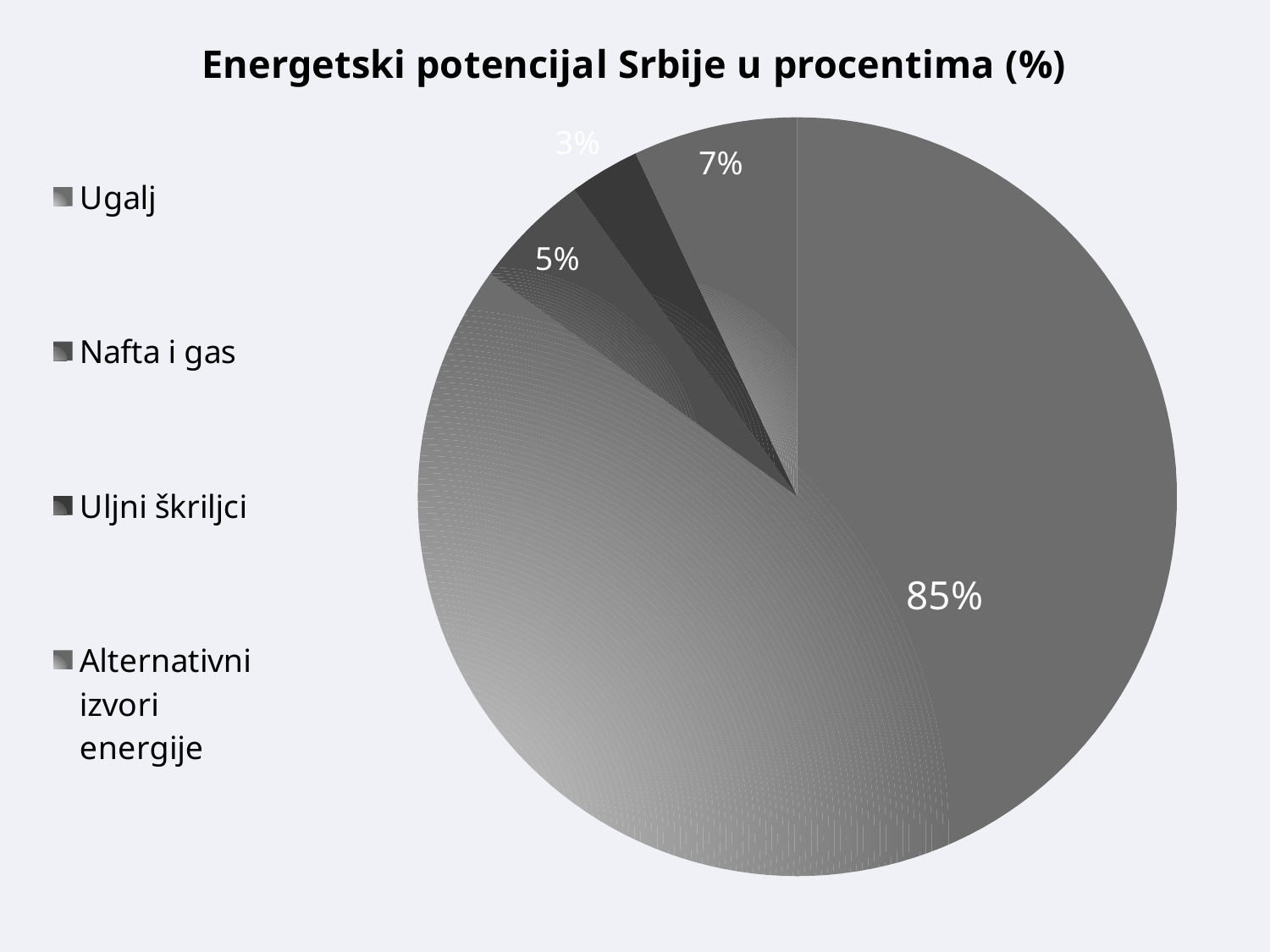
Which legend entry is listed first? Ugalj What kind of chart is shown on the slide? pie chart What is the difference in percentage points between the Ugalj slice and the Alternativni izvori energije slice? 78% How many categories does the pie chart have? 4 What is the title of the chart? Energetski potencijal Srbije u procentima (%) What share of the pie does Alternativni izvori energije have? 7% Which is larger, the slice for Nafta i gas or the slice for Alternativni izvori energije? Alternativni izvori energije What share of the pie does Nafta i gas have? 5% What share of the pie does Uljni škriljci have? 3% Which category has the largest slice of the pie? Ugalj Which category has the smallest slice of the pie? Uljni škriljci